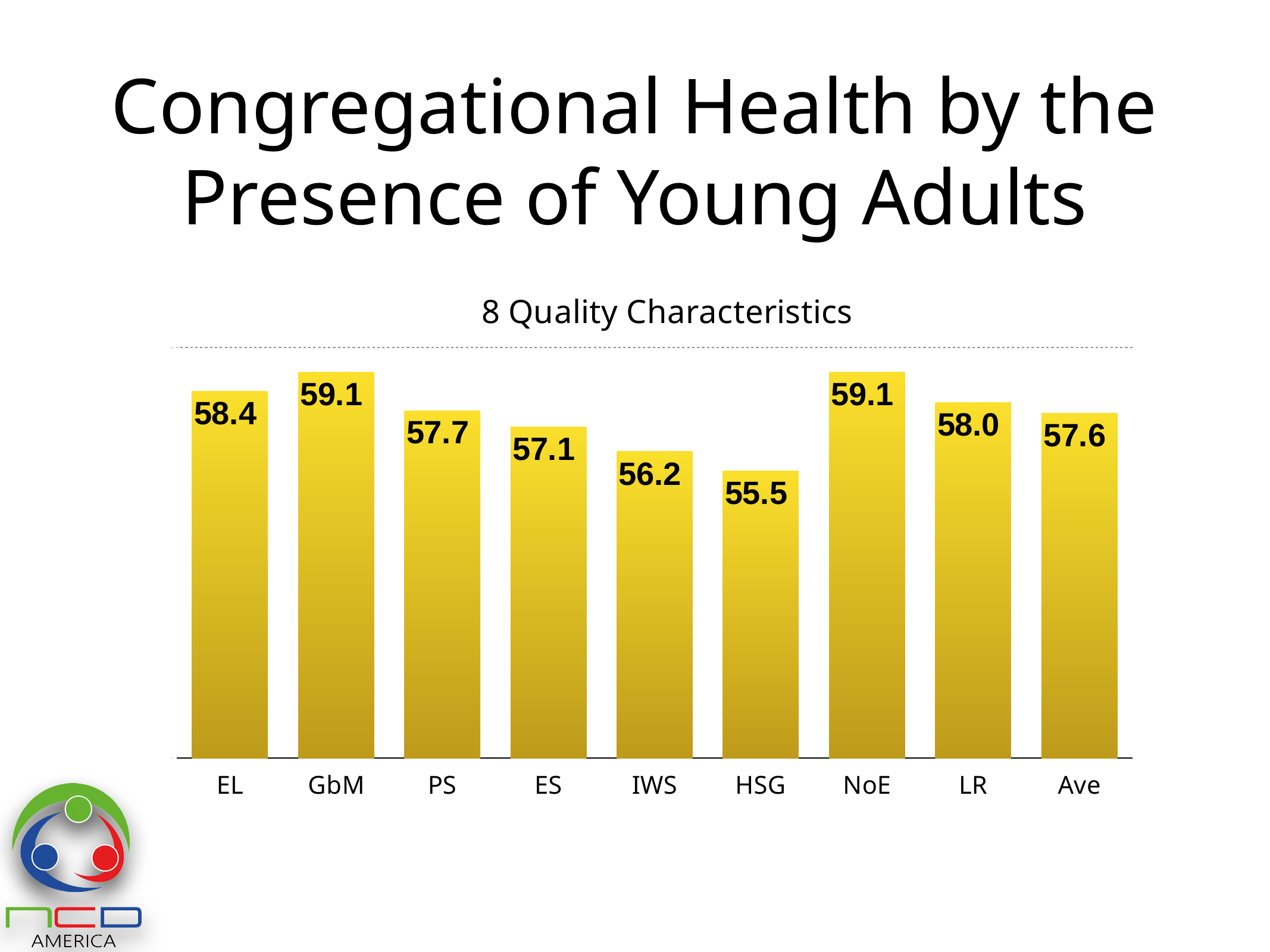
What is the value for LR? 58.0 What is the difference between the values for EL and ES? 1.3 What is the difference between the values for GbM and HSG? 3.6 What is the title of the chart? 8 Quality Characteristics What is the value for Ave? 57.6 Which category has the lowest value? HSG Which is larger, the value for PS or the value for IWS? PS How many categories are shown on the x axis? 9 What kind of chart is shown on the slide? bar chart What is the value for HSG? 55.5 What is the value for IWS? 56.2 What is the value for EL? 58.4